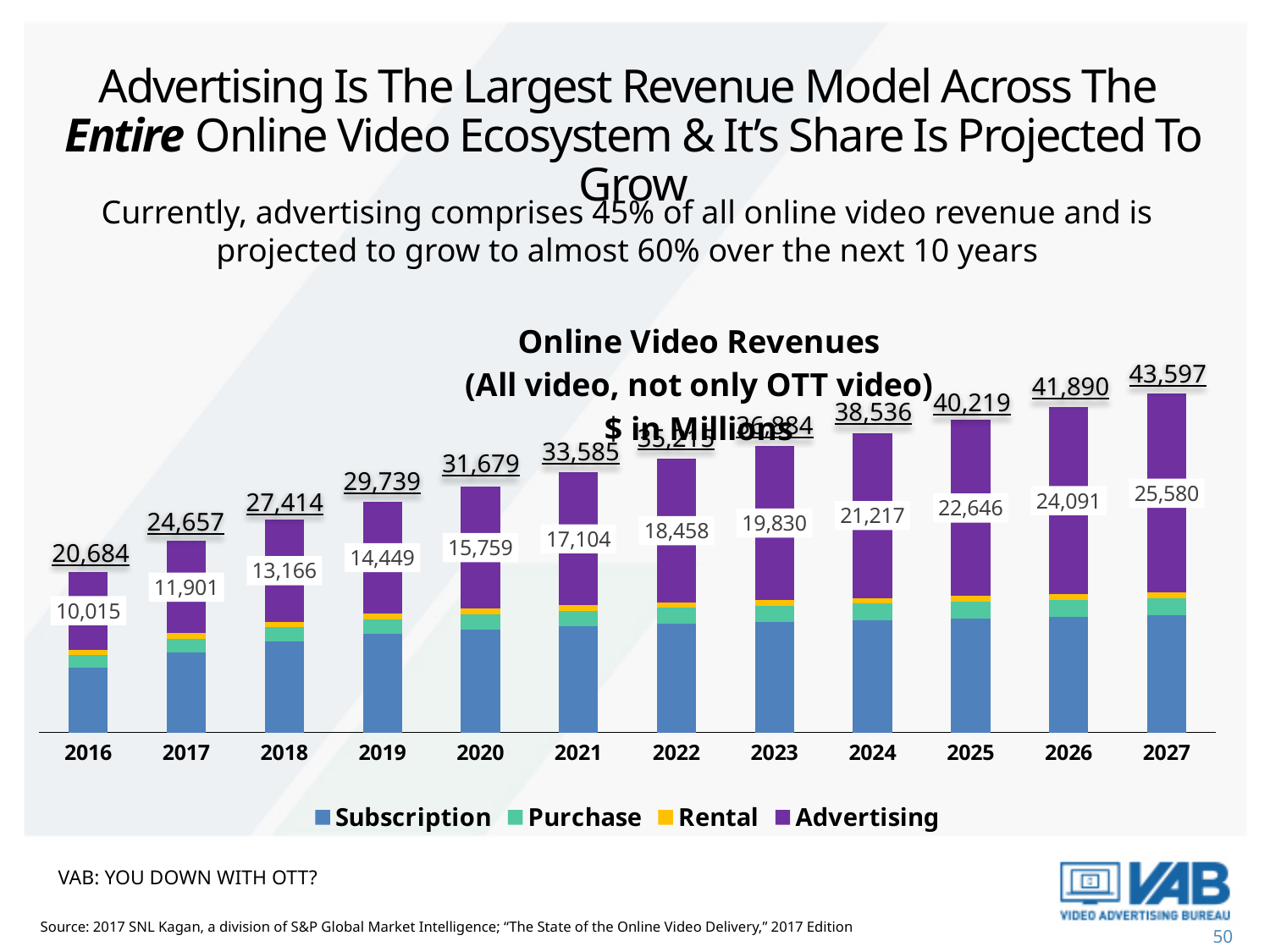
How many years are shown on the x axis? 12 What is the Advertising value for 2027? 25,580 Which is larger, the Advertising value for 2024 or for 2025? 2025 How many series does the legend list? 4 What is the difference between the Advertising values for 2027 and 2016? 15,565 Which year has the highest total online video revenue? 2027 What is the total online video revenue shown for 2019? 29,739 What is the Advertising value for 2016? 10,015 Do the Advertising values rise or fall from 2016 to 2027? rise Which year has the lowest Advertising value? 2016 What is the difference between the total revenues for 2021 and 2020? 1,906 What is the total online video revenue shown for 2026? 41,890